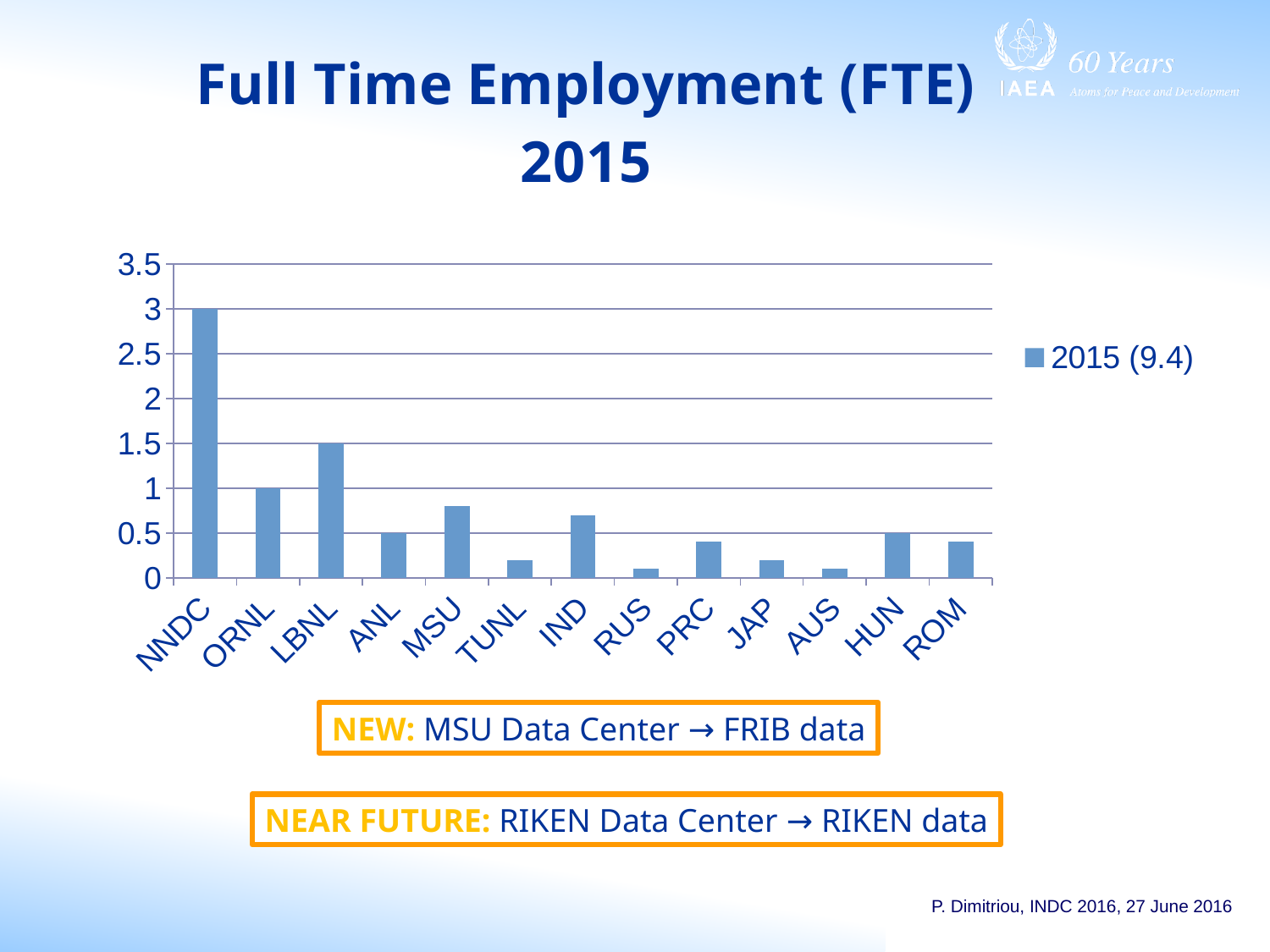
What is the value for LBNL? 1.5 What is the value for ORNL? 1 How many categories are shown on the x axis of the chart? 13 What type of chart is shown on the slide? bar chart Is the value for TUNL greater or less than 0.5? less Is the value for MSU greater or less than 0.5? greater What is the difference between the values for NNDC and LBNL? 1.5 What is the legend entry for the series in the chart? 2015 (9.4) Which category has the highest value in the chart? NNDC What is the value for NNDC? 3 Which is larger, the value for LBNL or the value for ORNL? LBNL How many series does the legend list? 1